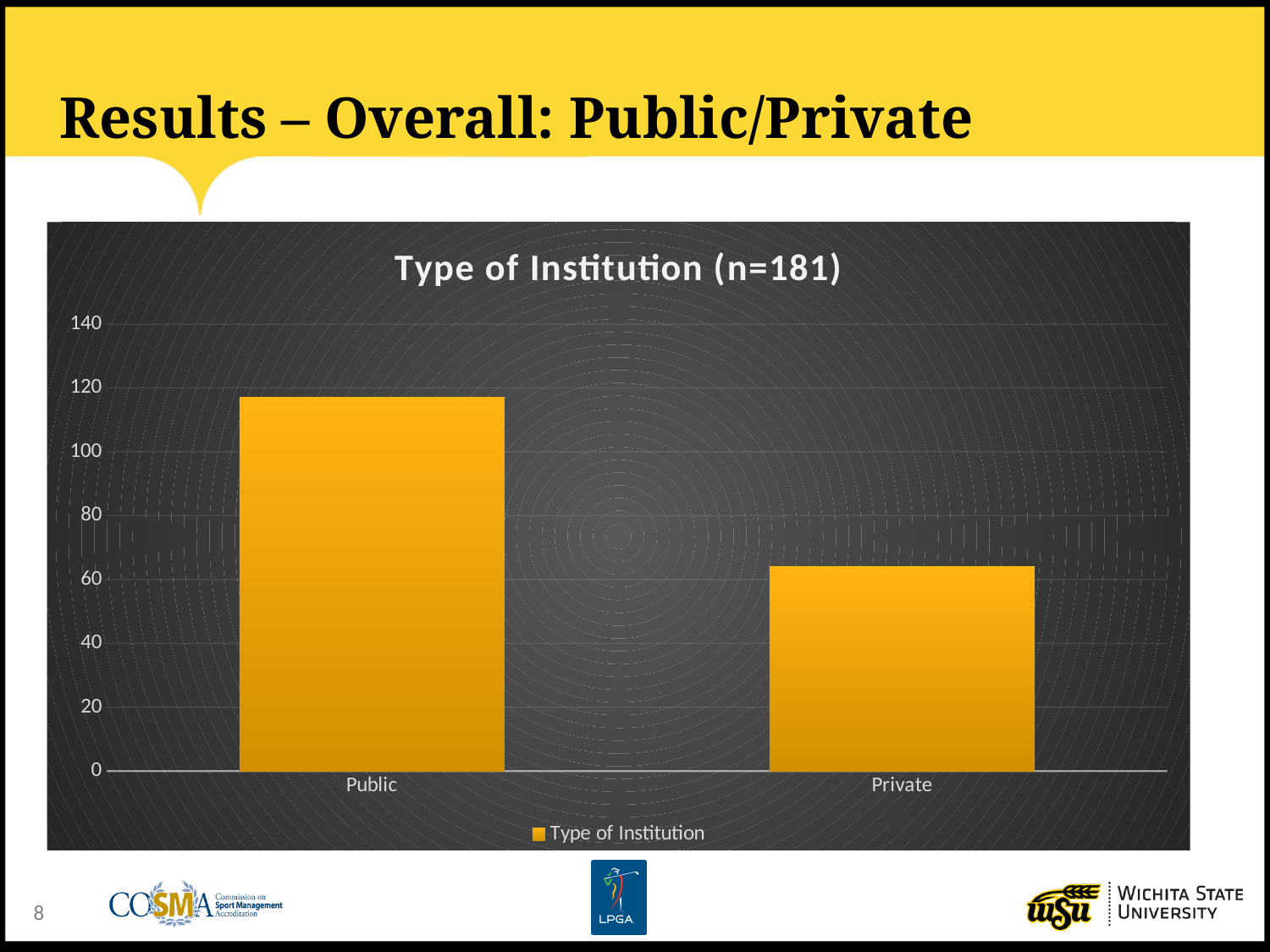
How many series does the chart legend list? 1 What kind of chart is shown on the slide? bar chart How many categories are shown on the x axis of the chart? 2 Is the value for Private greater or less than 80? less Is the value for Private greater or less than 40? greater Which category has the highest bar in the chart? Public Is the value for Public greater or less than 100? greater Which is larger, the value for Public or the value for Private? Public Which category has the lowest bar in the chart? Private What is the title of the chart? Type of Institution (n=181) What is the name of the series shown in the chart legend? Type of Institution